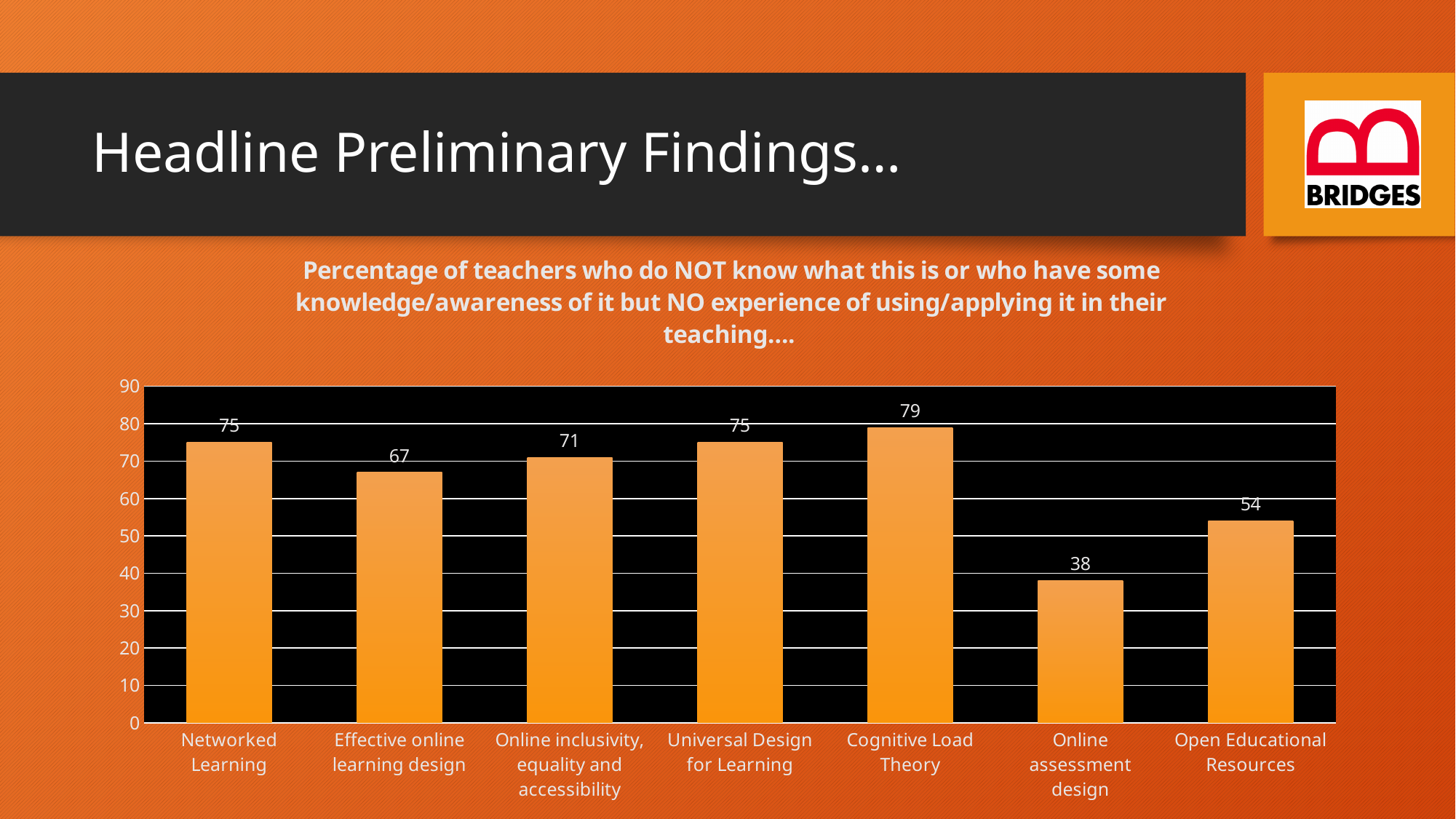
How many categories are shown on the x axis? 7 What is the difference between the values for Cognitive Load Theory and Online assessment design? 41 Is the value for Online assessment design greater or less than 40? less What is the value for Open Educational Resources? 54 What is the value for Online assessment design? 38 Which category has the highest value? Cognitive Load Theory Which is larger, the value for Online inclusivity, equality and accessibility or the value for Open Educational Resources? Online inclusivity, equality and accessibility What is the difference between the values for Networked Learning and Effective online learning design? 8 What kind of chart is shown on the slide? bar chart Which category has the lowest value? Online assessment design What is the value for Effective online learning design? 67 What is the value for Cognitive Load Theory? 79